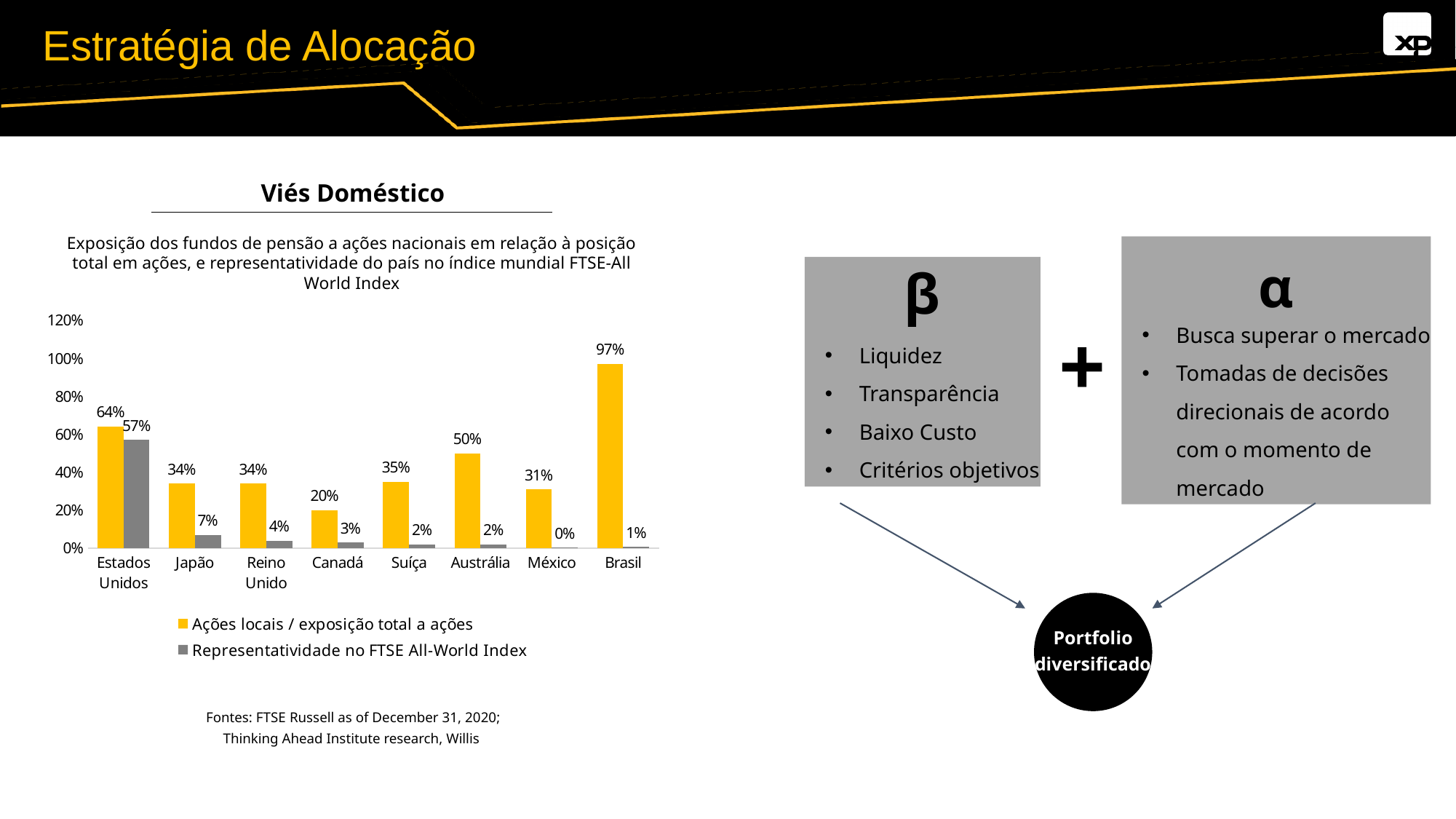
Which country has the highest value for 'Ações locais / exposição total a ações'? Brasil Is the value of 'Ações locais / exposição total a ações' for Estados Unidos greater or less than 60%? greater What is the value of 'Ações locais / exposição total a ações' for Canadá? 20% What colour represents 'Representatividade no FTSE All-World Index' in the chart? Grey What is the value of 'Ações locais / exposição total a ações' for Brasil? 97% What is the difference between the two series for Austrália? 48% Which is larger: 'Ações locais / exposição total a ações' for Suíça or for México? Suíça How many countries are shown on the x axis of the chart? 8 What kind of chart is shown on the slide? Bar chart How many series does the chart legend list? 2 What is the value of 'Representatividade no FTSE All-World Index' for Estados Unidos? 57% Which country has the lowest value for 'Representatividade no FTSE All-World Index'? México